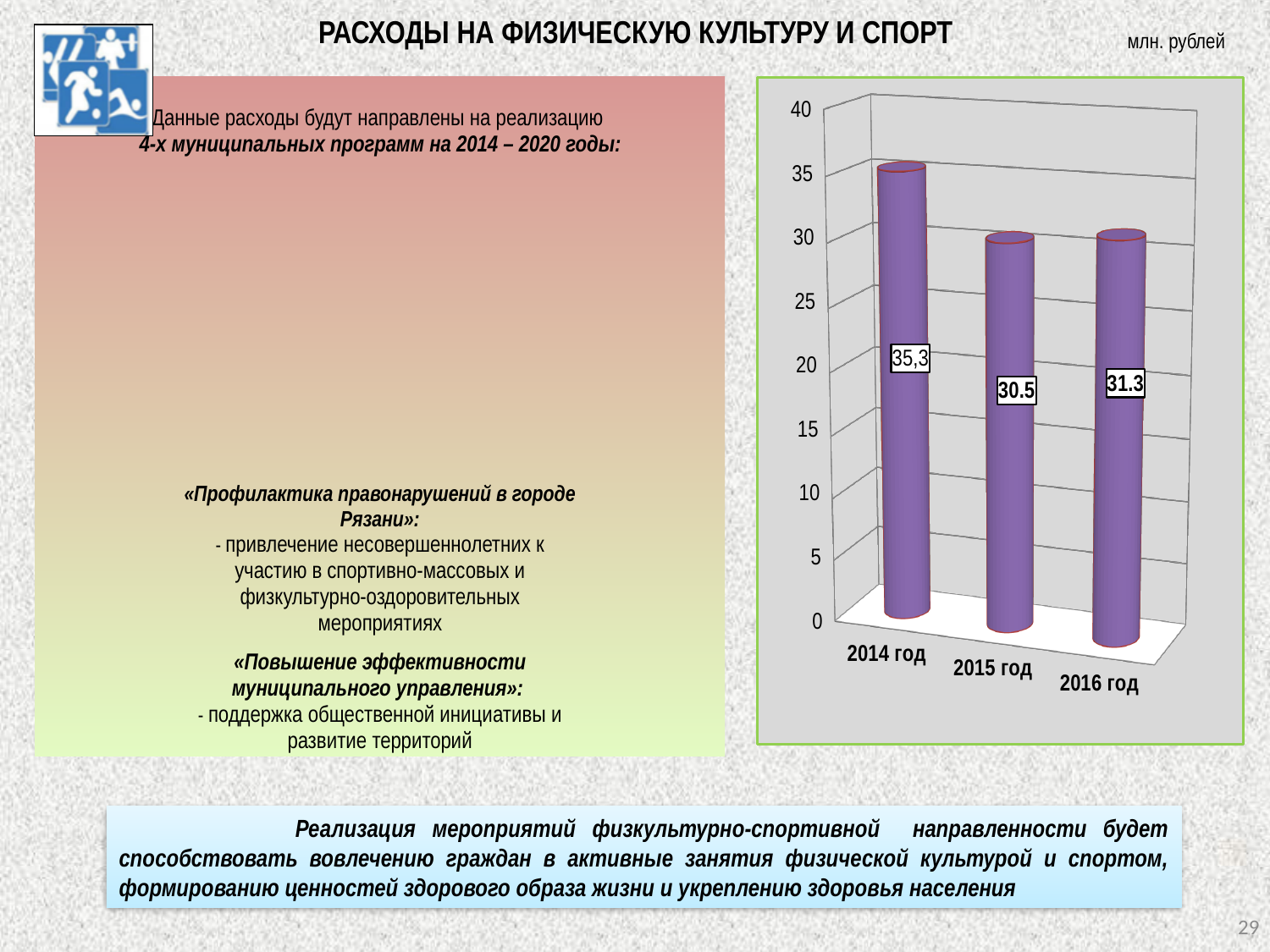
What kind of chart is shown on the slide? bar chart What unit of measurement is indicated for the chart? млн. рублей What is the value for 2015 год? 30.5 What is the difference between the values for 2014 год and 2015 год? 4.8 Which year has the lowest value? 2015 год Is the value for 2015 год greater or less than 35? less Which is larger, the value for 2015 год or the value for 2016 год? 2016 год What is the value for 2016 год? 31.3 What is the value for 2014 год? 35,3 How many years are shown on the chart? 3 Which year has the highest value? 2014 год What is the difference between the values for 2016 год and 2015 год? 0.8